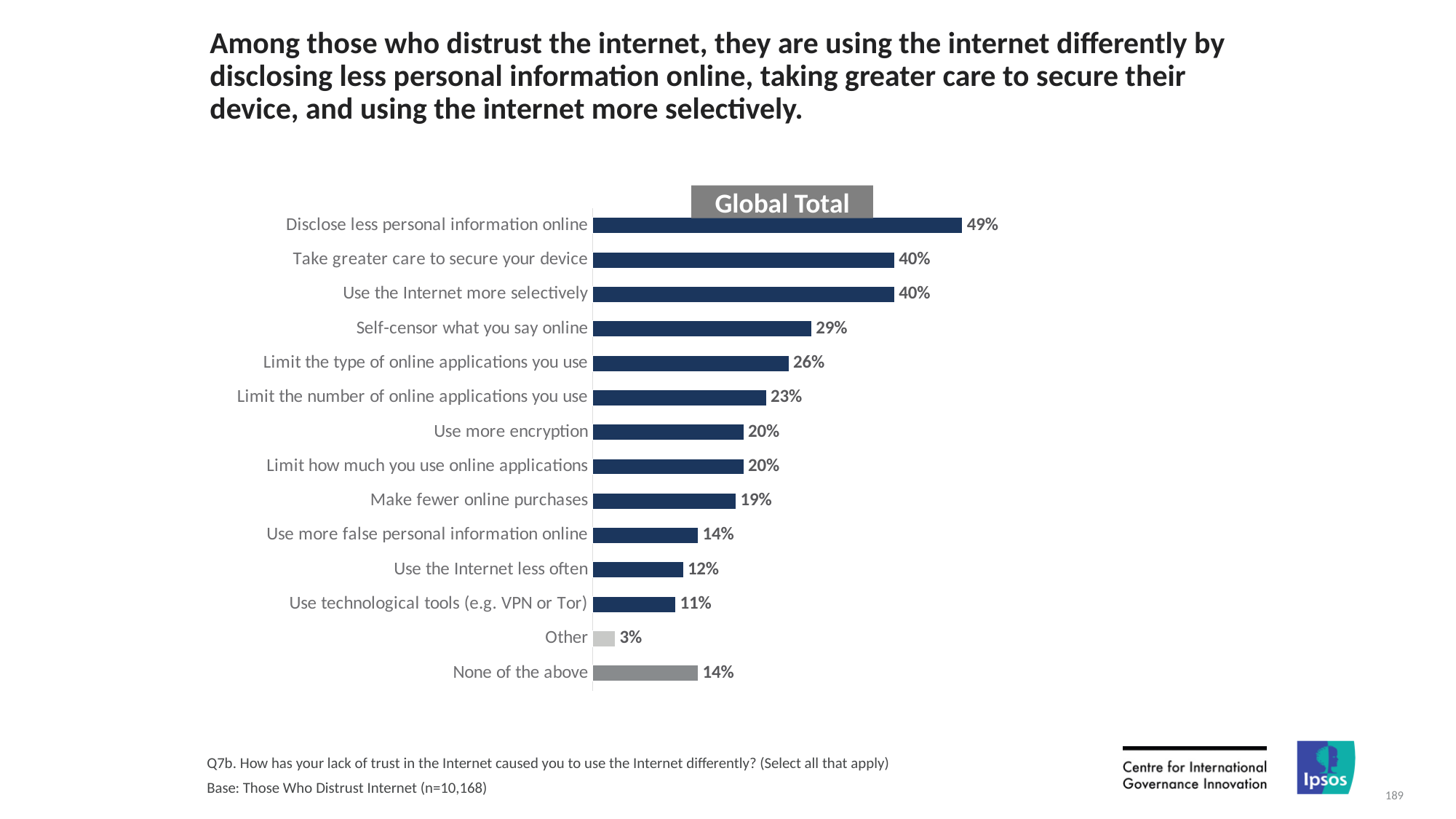
What is the label shown in the grey box above the chart? Global Total What is the difference between 'Disclose less personal information online' and 'Take greater care to secure your device'? 9% How many categories are shown in the chart? 14 What is the value for 'Use technological tools (e.g. VPN or Tor)'? 11% What is the value for 'Self-censor what you say online'? 29% What is the difference between 'Limit the type of online applications you use' and 'Limit the number of online applications you use'? 3% Which category has the highest value in the chart? Disclose less personal information online What kind of chart is shown on the slide? Bar chart What percentage of those who distrust the internet say they disclose less personal information online? 49% Which category has the lowest value in the chart? Other Which is larger: 'Make fewer online purchases' or 'Use the Internet less often'? Make fewer online purchases What is the value for 'None of the above'? 14%